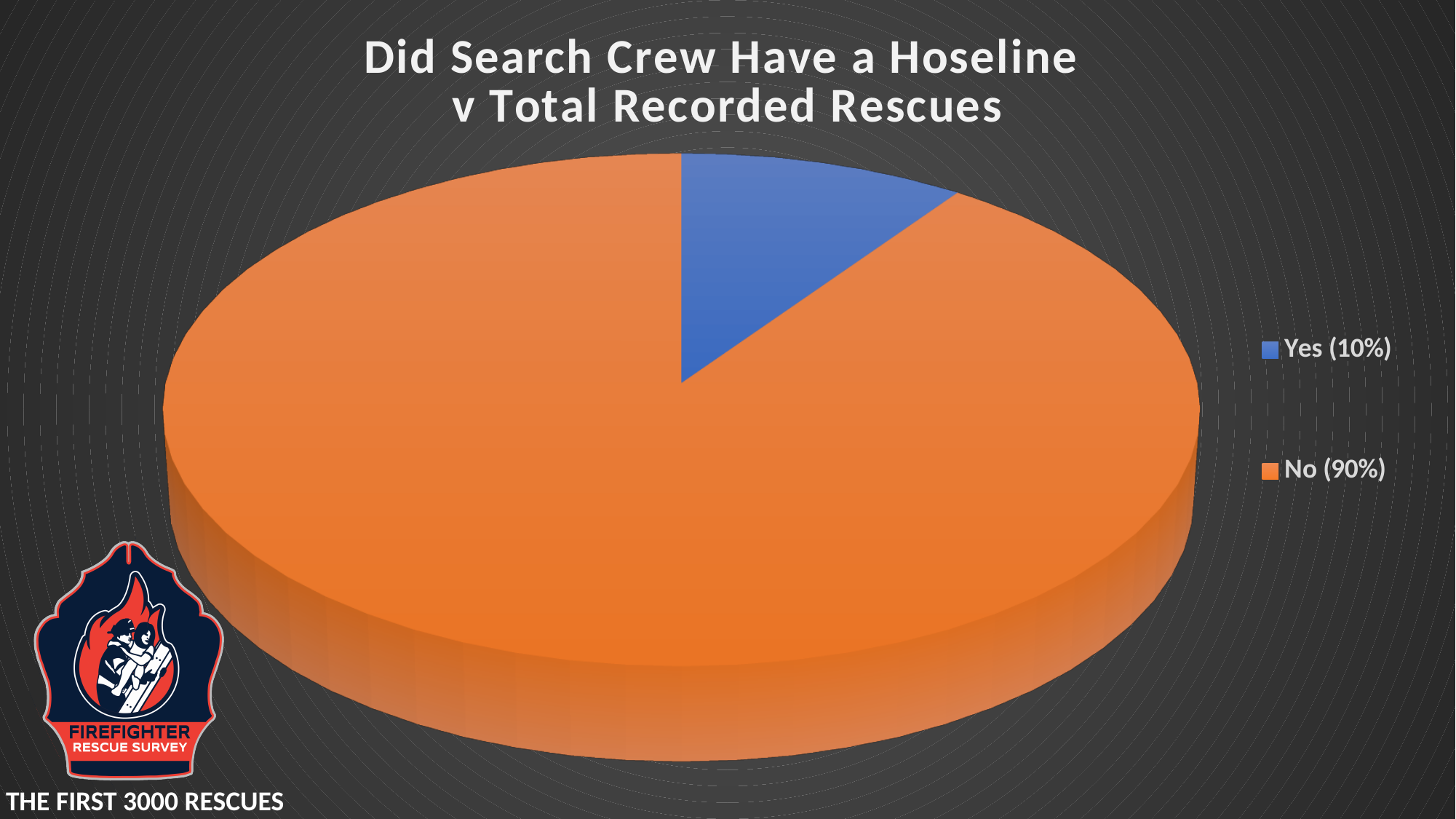
What is the title of the chart? Did Search Crew Have a Hoseline v Total Recorded Rescues What share of the pie does the "No" slice represent? 90% Which is larger, the "Yes" slice or the "No" slice? No How many categories does the pie chart show? 2 Which category has the smallest slice of the pie? Yes What share of the pie does the "Yes" slice represent? 10% Which category has the largest slice of the pie? No What kind of chart is shown on the slide? pie chart What is the difference in percentage points between the "No" and "Yes" slices? 80 What colour is the "Yes" slice? blue Is the share for "Yes" greater or less than 50%? less